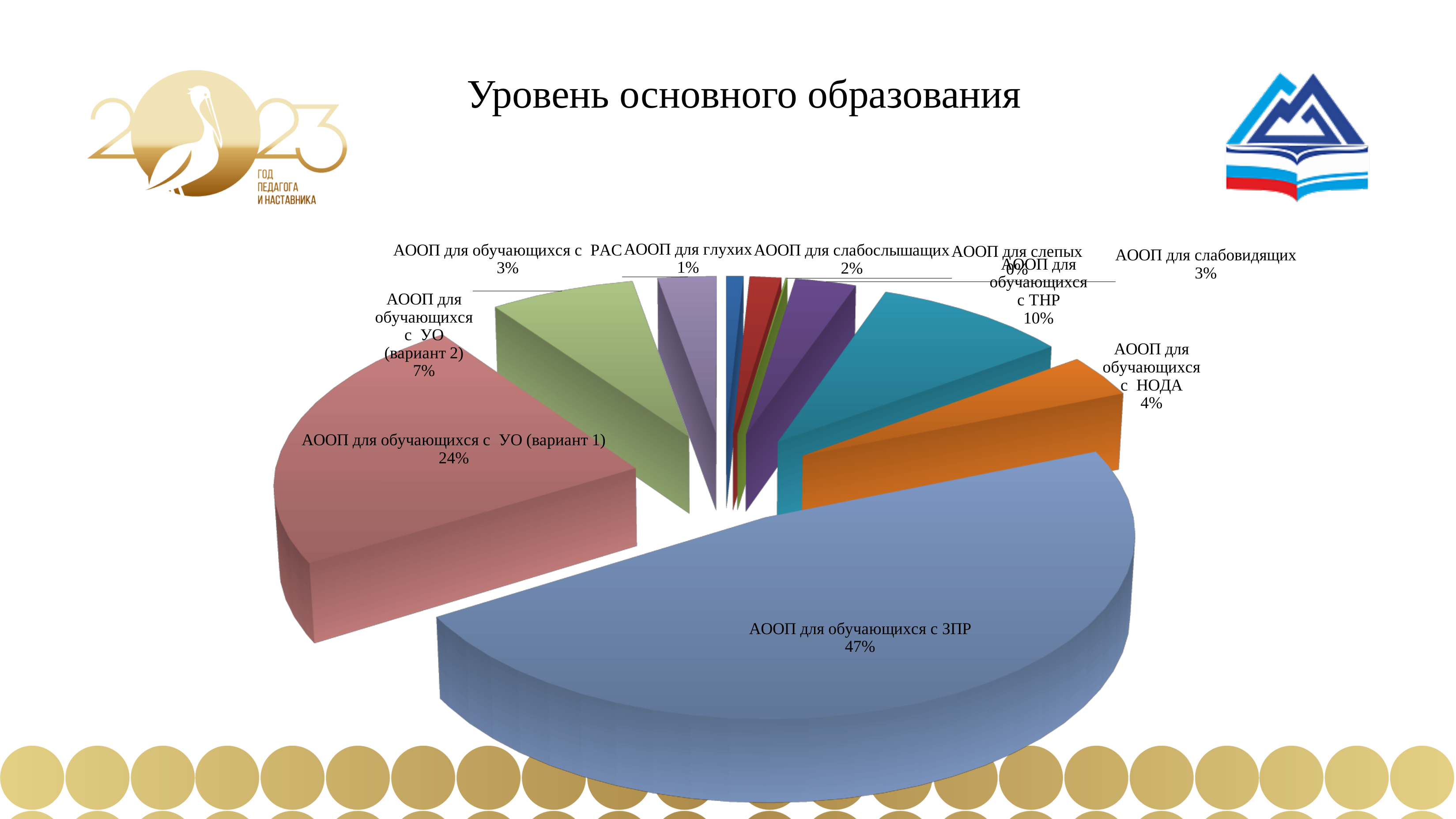
What share of the pie is labelled for АООП для обучающихся с НОДА? 4% Which category has the largest share of the pie? АООП для обучающихся с ЗПР How many categories (slices) does the pie chart have? 10 What share of the pie is labelled for АООП для обучающихся с ТНР? 10% Which category has the smallest share of the pie? АООП для слепых What share of the pie is labelled for АООП для обучающихся с ЗПР? 47% What is the title of the chart on the slide? Уровень основного образования What kind of chart is shown on the slide? pie chart What share of the pie is labelled for АООП для обучающихся с УО (вариант 1)? 24% What share of the pie is labelled for АООП для глухих? 1% What share of the pie is labelled for АООП для слепых? 0% What is the difference in percentage points between АООП для обучающихся с ЗПР and АООП для обучающихся с УО (вариант 1)? 23